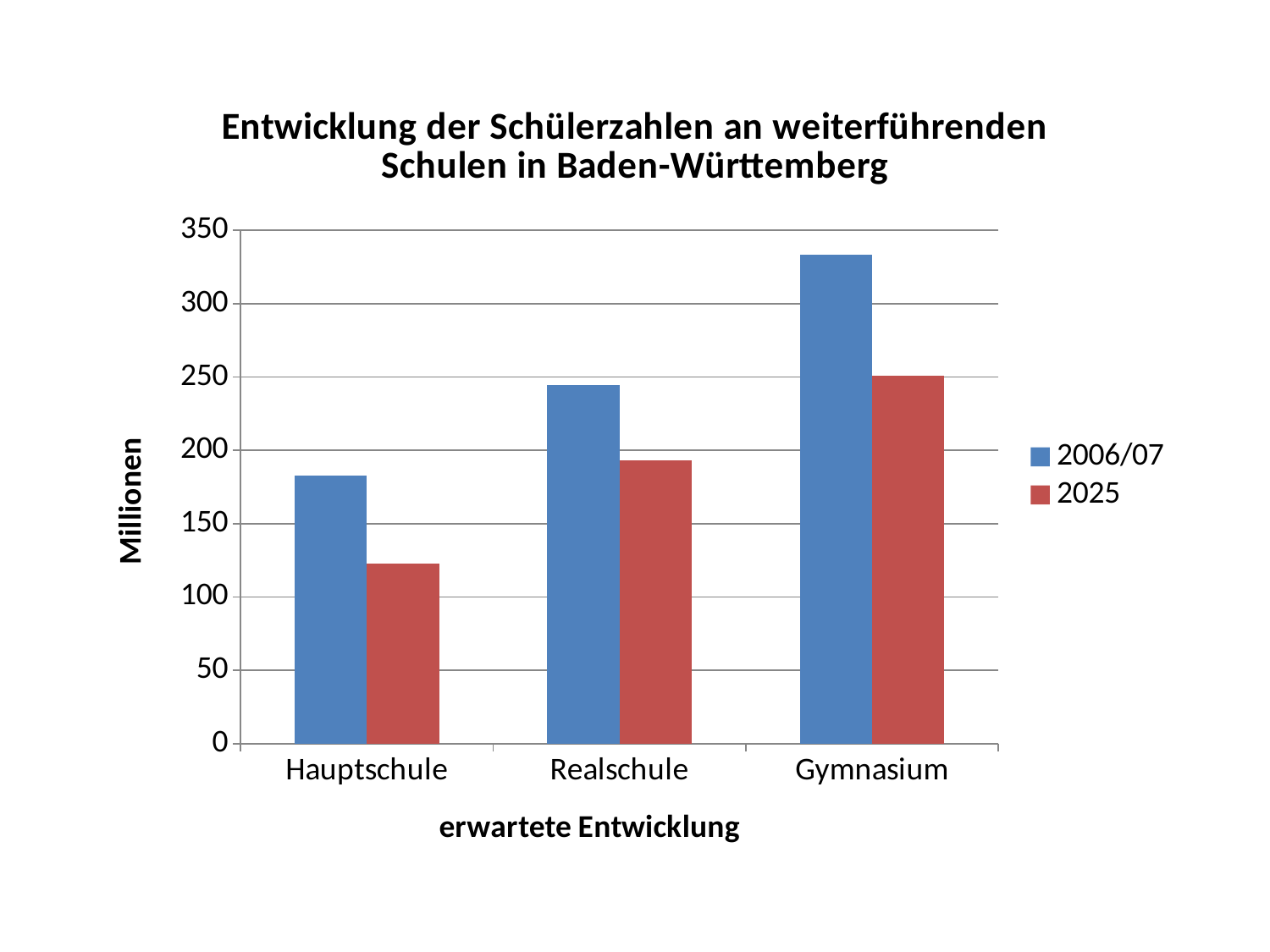
Is the 2025 value for Gymnasium greater or less than 300? less What is the label of the x axis? erwartete Entwicklung What kind of chart is shown on the slide? bar chart How many series does the legend list? 2 What is the label of the y axis? Millionen Is the 2006/07 value for Hauptschule greater or less than 150? greater Is the 2006/07 value for Gymnasium greater or less than 300? greater Which school type has the lowest value for 2025? Hauptschule How many school types are shown on the x axis? 3 Which school type has the highest value for 2006/07? Gymnasium For Realschule, which is larger: the 2006/07 value or the 2025 value? 2006/07